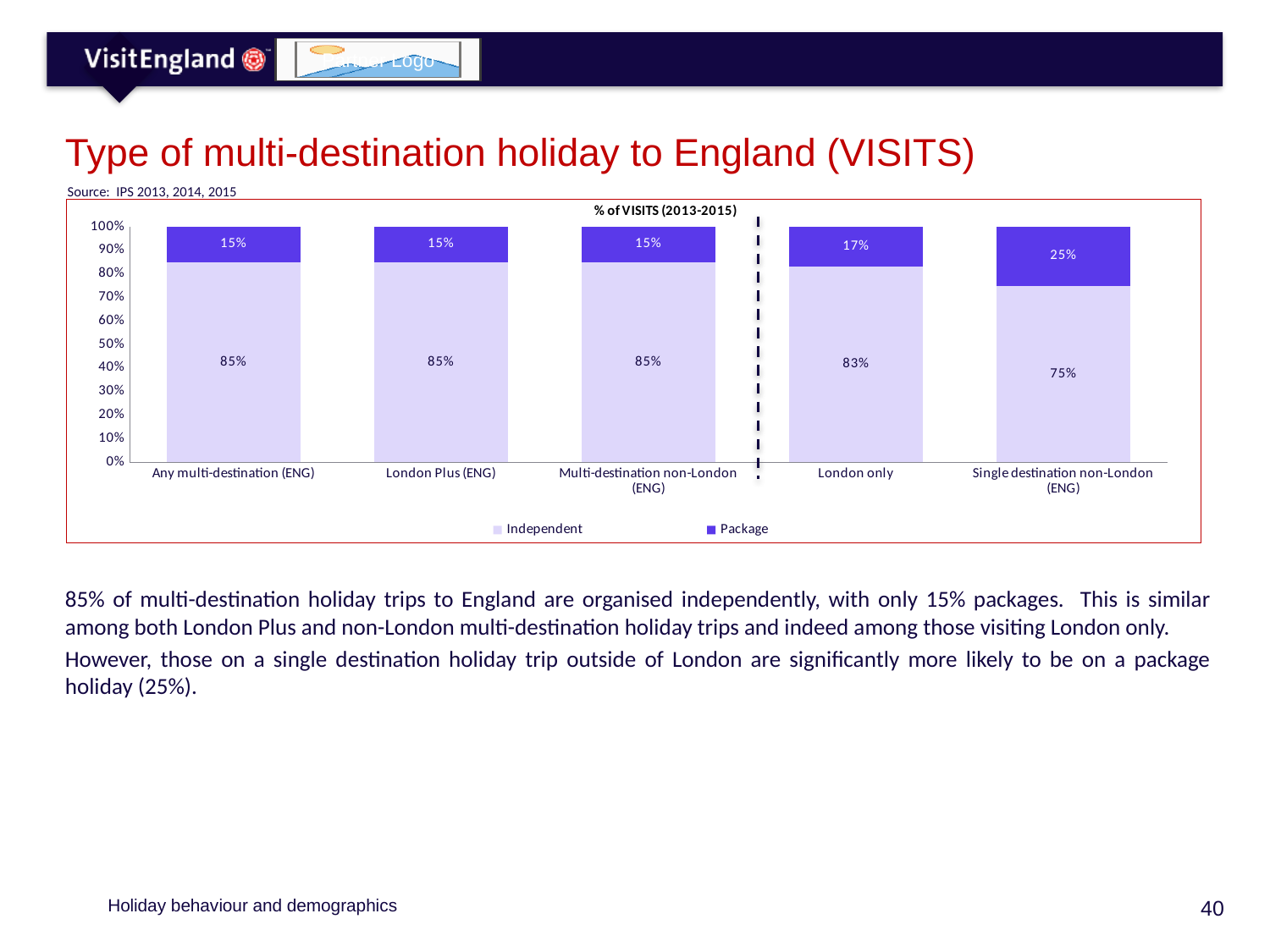
Which is larger: the Package share for London only or for London Plus (ENG)? London only What kind of chart is shown on the slide? Stacked bar chart What is the total of the stacked bar for London only? 100% What is the difference between the Package share for Single destination non-London (ENG) and for London only? 8% How many categories are shown on the x axis? 5 What is the Independent share for Any multi-destination (ENG)? 85% Which category has the highest Package share? Single destination non-London (ENG) What is the title shown above the chart's plot area? % of VISITS (2013-2015) What is the Package share for Single destination non-London (ENG)? 25% How many series does the legend list? 2 What is the Independent share for London only? 83% Which category has the lowest Independent share? Single destination non-London (ENG)